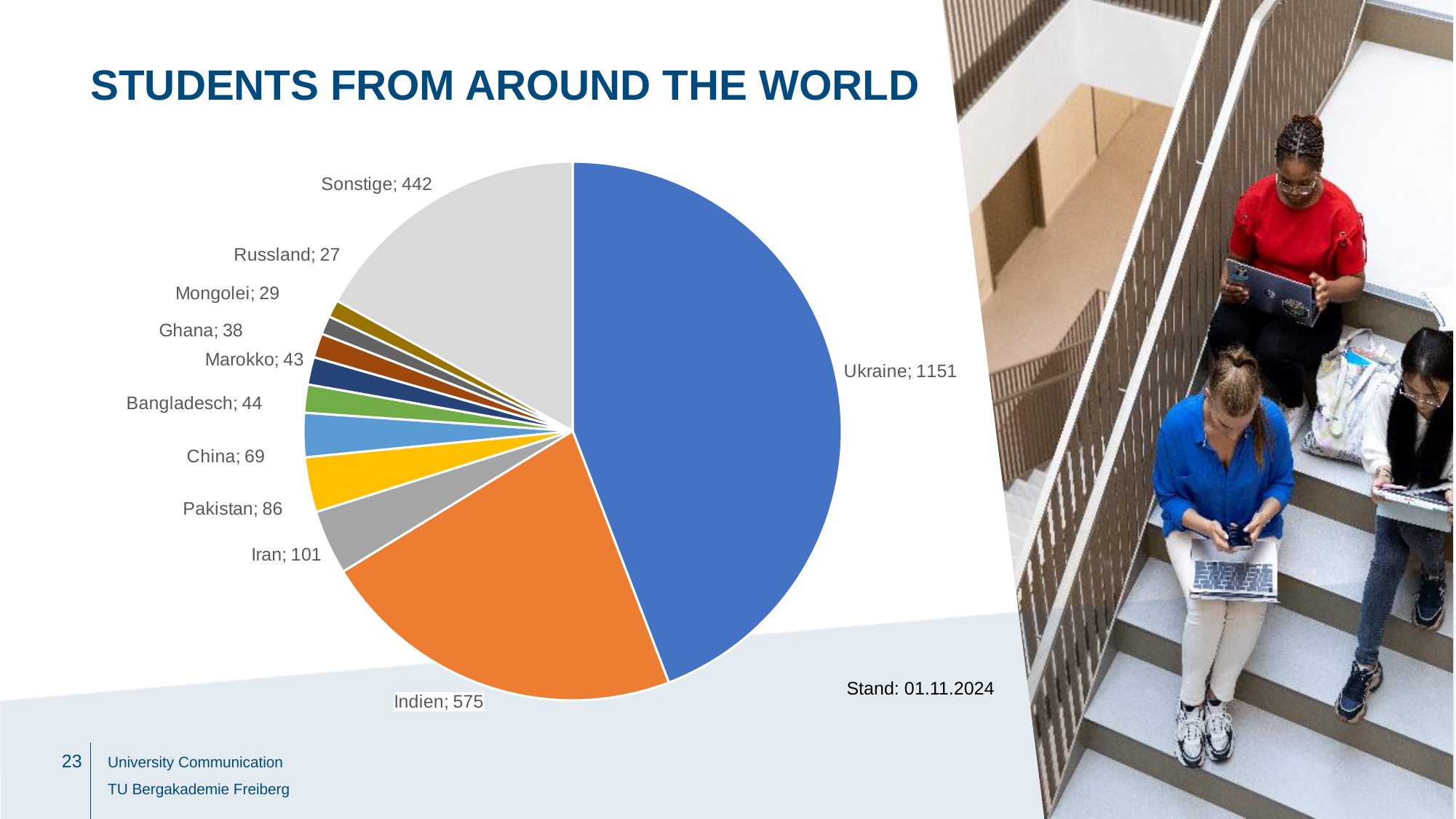
What type of chart is shown on the slide? Pie chart Which category has the smallest value in the pie chart? Russland How many categories (slices) does the pie chart show? 11 What date is given as the status (Stand) of the chart data? 01.11.2024 Which has a larger value, Pakistan or China? Pakistan What is the title of the slide containing the chart? STUDENTS FROM AROUND THE WORLD What is the difference between the values for Ukraine and Indien? 576 What value is shown for Iran in the pie chart? 101 How many students are from Ukraine according to the pie chart? 1151 What value is shown for Indien in the pie chart? 575 What value is shown for Sonstige in the pie chart? 442 Which country has the largest slice in the pie chart? Ukraine